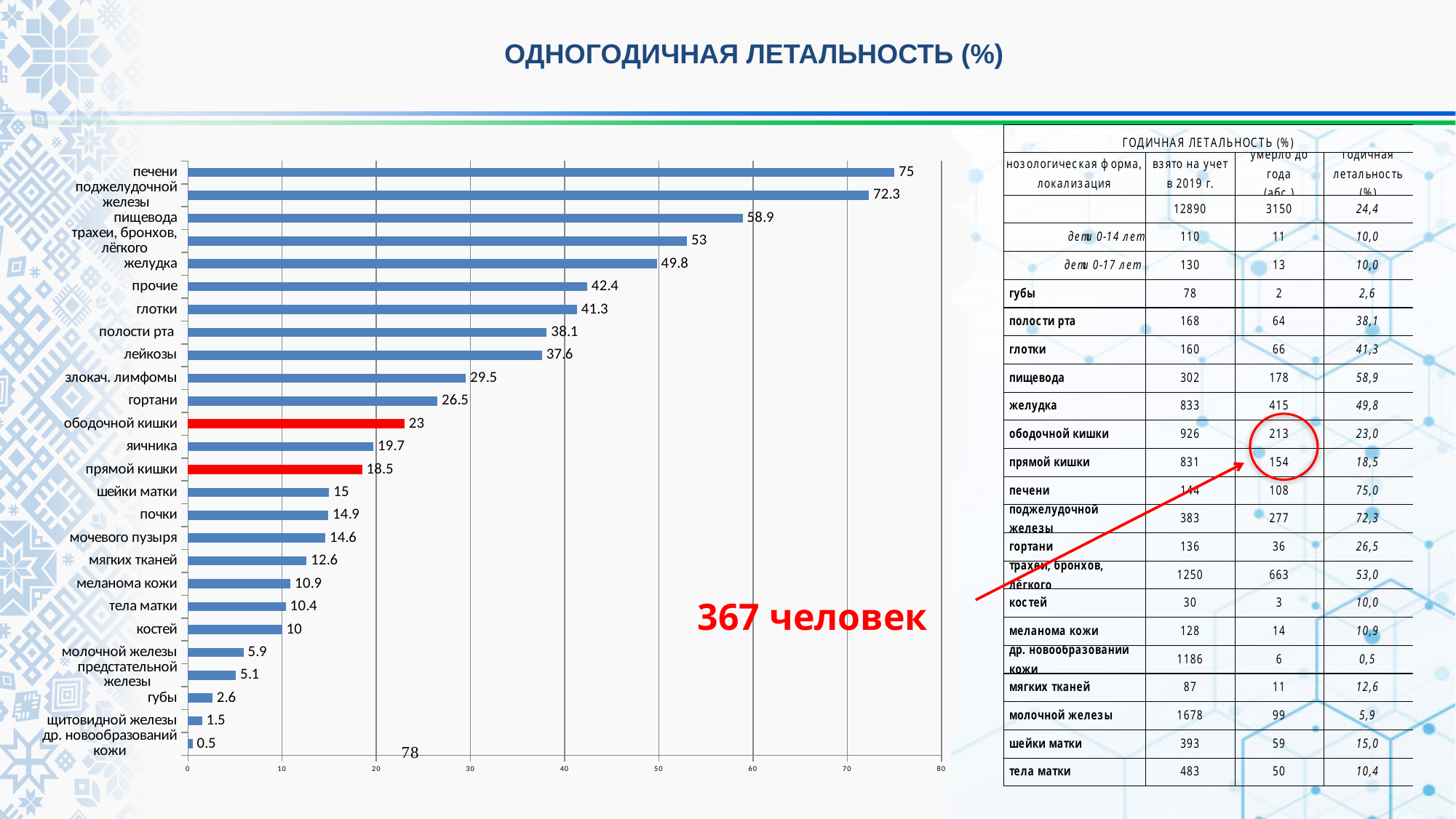
Is the value for гортани greater or less than 30? less What value is shown for прямой кишки? 18.5 What is the difference between the values for печени and поджелудочной железы? 2.7 What is the one-year lethality value shown for печени? 75 Which category has the lowest value in the bar chart? др. новообразований кожи How many categories are plotted in the bar chart? 26 What type of chart is shown on the slide? bar chart Which has a larger value, желудка or пищевода? пищевода Which category has the highest value in the bar chart? печени What is the difference between the values for ободочной кишки and прямой кишки? 4.5 Which two bars in the chart are coloured red? ободочной кишки and прямой кишки What value is labelled on the bar for ободочной кишки? 23